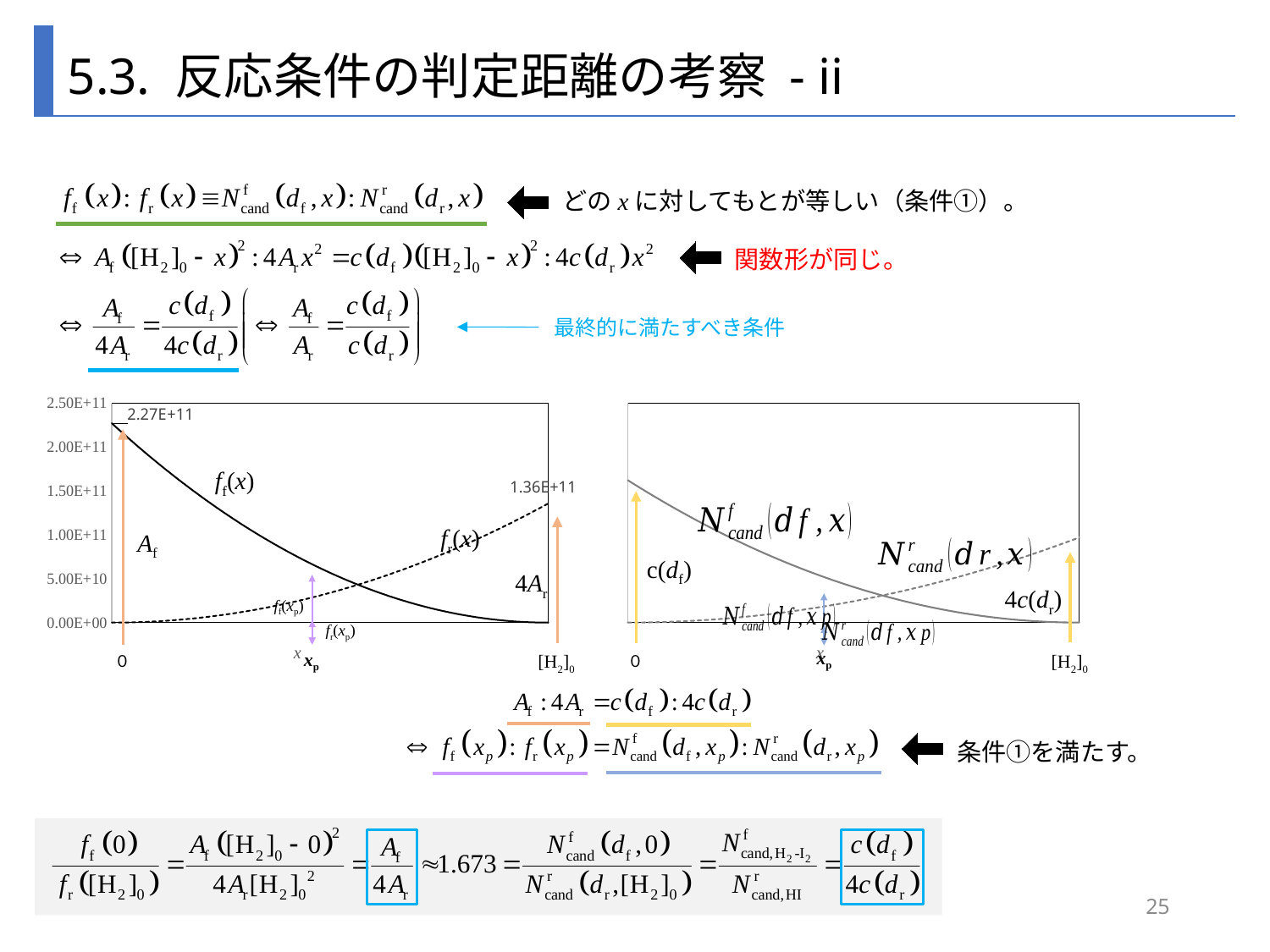
On the left chart, does f_f(x) rise or fall as x increases from 0 to [H2]0? fall On the right chart, which curve is higher at x = 0, N^f_cand(df, x) or N^r_cand(dr, x)? N^f_cand(df, x) On the left chart, which curve has the larger value at x = 0, f_f(x) or f_r(x)? f_f(x) How many curves are plotted on the left chart? 2 What kind of chart is the left chart? line chart On the left chart, does f_r(x) rise or fall as x increases from 0 to [H2]0? rise On the left chart, what is the labelled value of f_f(x) at x = 0? 2.27E+11 On the left chart, what is the highest value shown on the y axis? 2.50E+11 On the left chart, what is the labelled value of f_r(x) at x = [H2]0? 1.36E+11 On the left chart, is the value of f_r(x) at x = [H2]0 greater or less than 1.50E+11? less On the left chart, is the value of f_f(x) at x = 0 greater or less than 2.00E+11? greater On the right chart, does the N^f_cand(df, x) curve rise or fall as x increases? fall